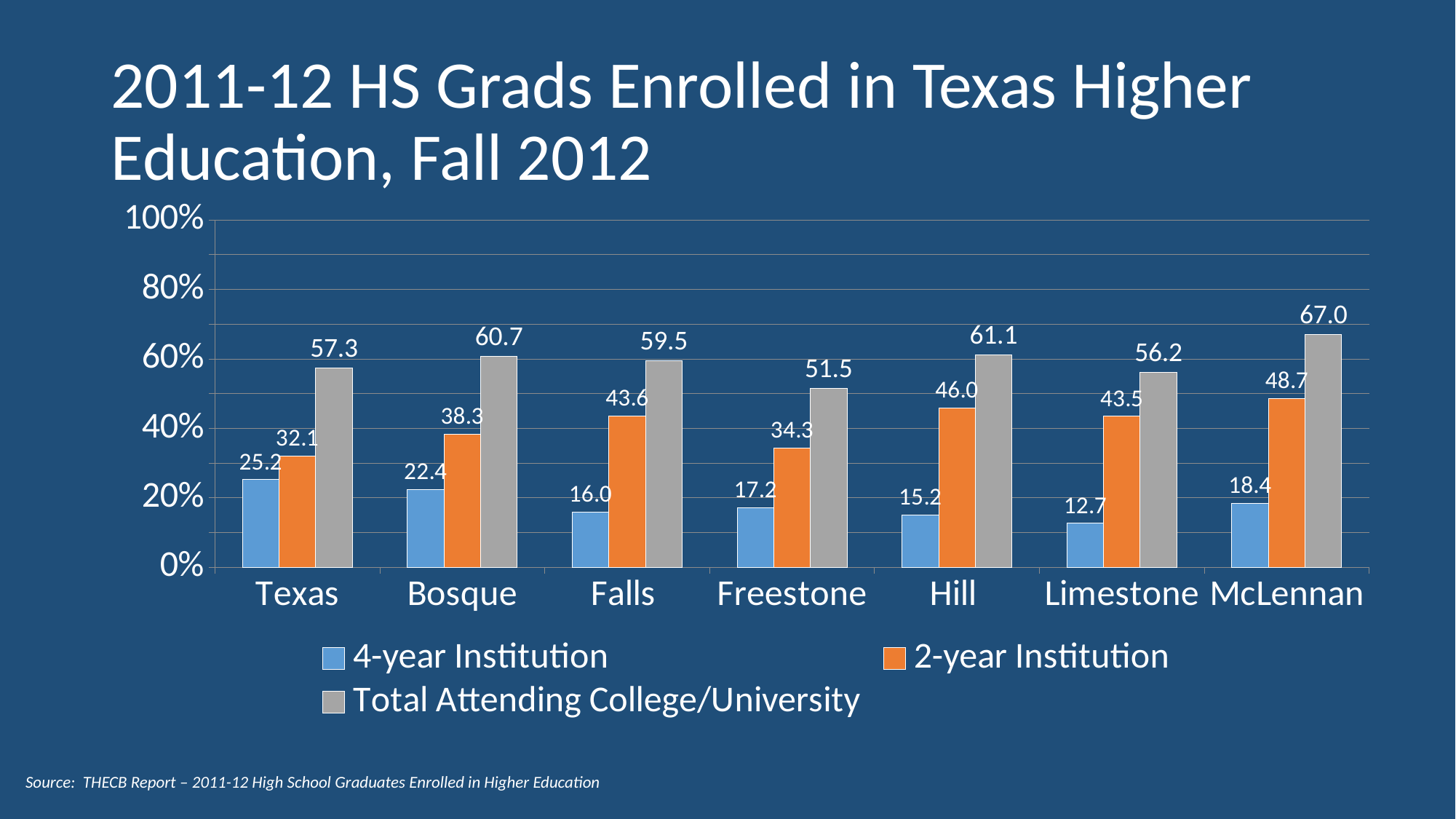
What is the difference between the 2-year Institution values for McLennan and Texas? 16.6 What is the title of the chart? 2011-12 HS Grads Enrolled in Texas Higher Education, Fall 2012 Which category has the highest Total Attending College/University value? McLennan Which is larger, the 4-year Institution value for Bosque or for Freestone? Bosque Which category has the lowest 4-year Institution value? Limestone How many categories are shown on the x axis? 7 What is the value for Total Attending College/University for McLennan? 67.0 What kind of chart is shown on the slide? Bar chart What is the value for 4-year Institution for Texas? 25.2 Which series is shown in orange? 2-year Institution What is the value for 2-year Institution for Hill? 46.0 How many series does the legend list? 3